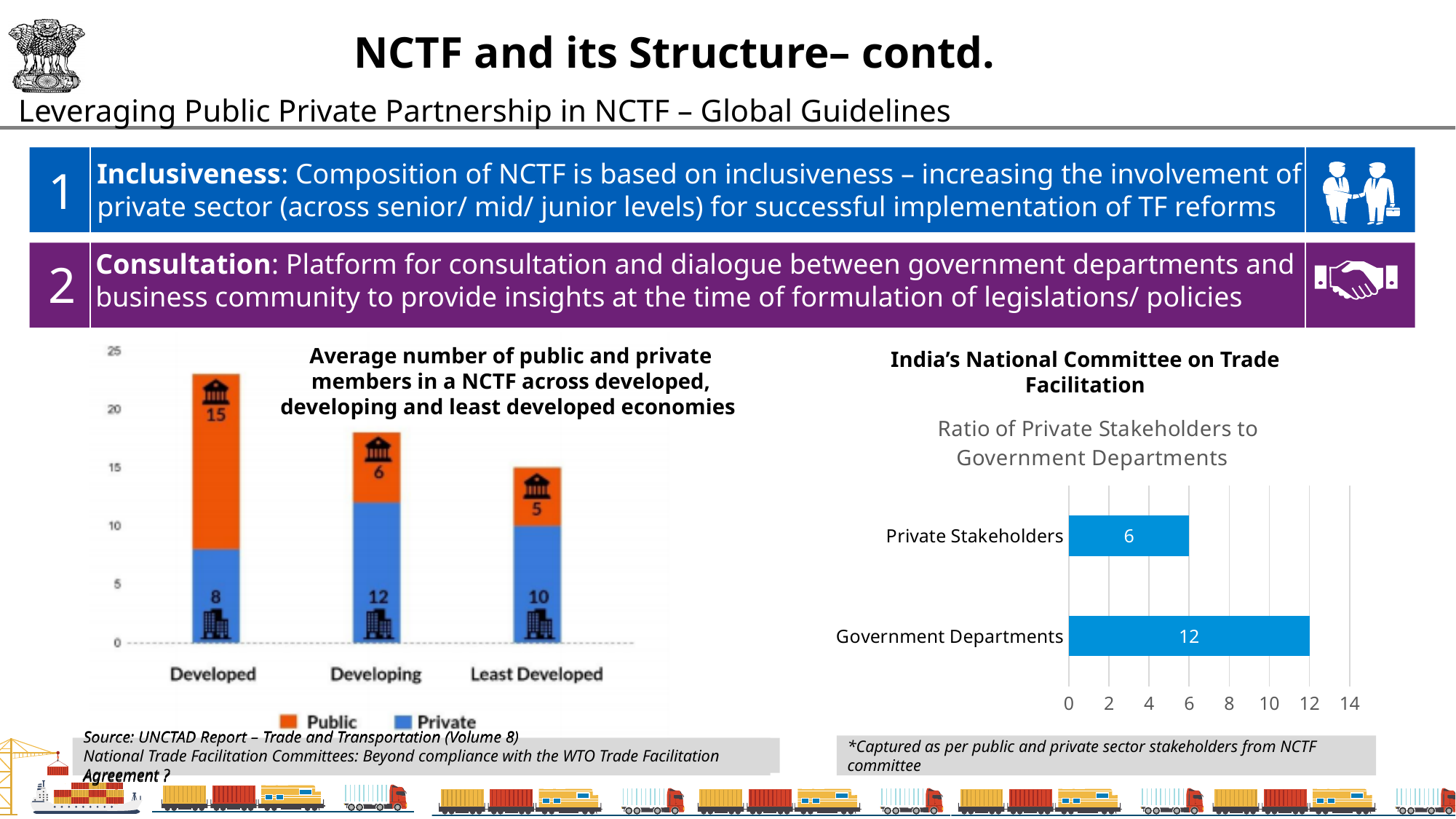
In the right chart on India's National Committee on Trade Facilitation, which category has the lower value? Private Stakeholders In the left chart on average NCTF members, what is the difference between the Private values for Developing and Developed economies? 4 In the left chart on average NCTF members, what is the total stacked value for Least Developed economies? 15 In the left chart on average NCTF members, what is the Public value for Developed economies? 15 In the left chart on average NCTF members, what is the total stacked value for Developed economies? 23 What kind of chart is the right chart on India's National Committee on Trade Facilitation? Bar chart In the left chart on average NCTF members, what is the Public value for Least Developed economies? 5 In the right chart on India's National Committee on Trade Facilitation, what is the value for Government Departments? 12 In the left chart on average NCTF members, which economy group has the highest Public value? Developed In the left chart on average NCTF members, how many series does the legend list? 2 In the left chart on average NCTF members, which colour represents the Public series? Orange In the left chart on average NCTF members, what is the Private value for Developing economies? 12